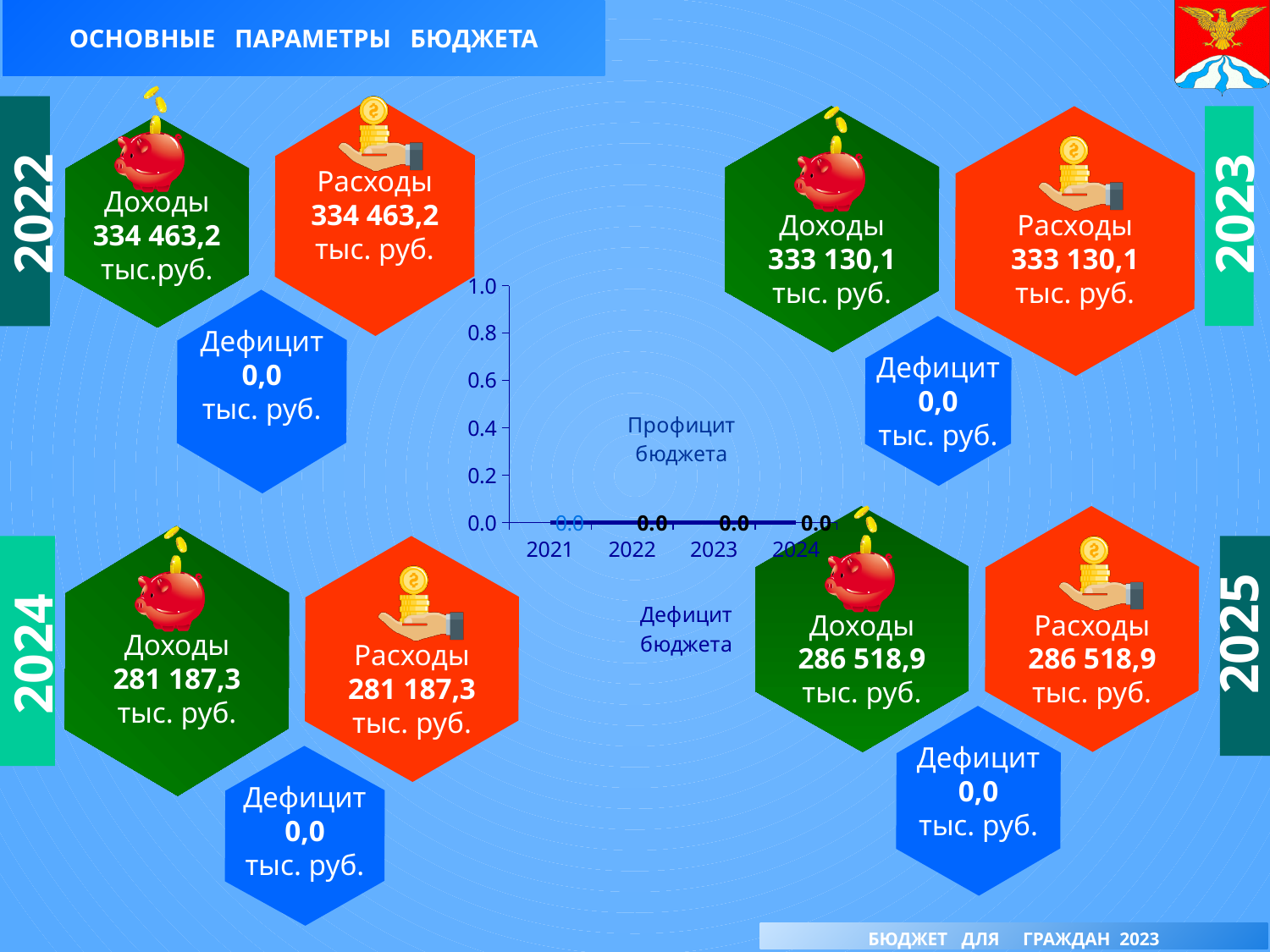
What is the difference between the values plotted for 2022 and 2024? 0.0 Do the plotted values rise, fall or stay flat from 2021 to 2024? stay flat Is the value plotted for 2023 greater or less than 0.2? less What is the value plotted for 2021 on the chart? 0.0 What kind of chart is shown in the centre of the slide? line chart What is the first year shown on the chart's x axis? 2021 How many years are shown on the x axis of the chart? 4 What is the value plotted for 2024 on the chart? 0.0 What is the value plotted for 2023 on the chart? 0.0 What is the value plotted for 2022 on the chart? 0.0 What is the highest value shown on the chart's y axis? 1.0